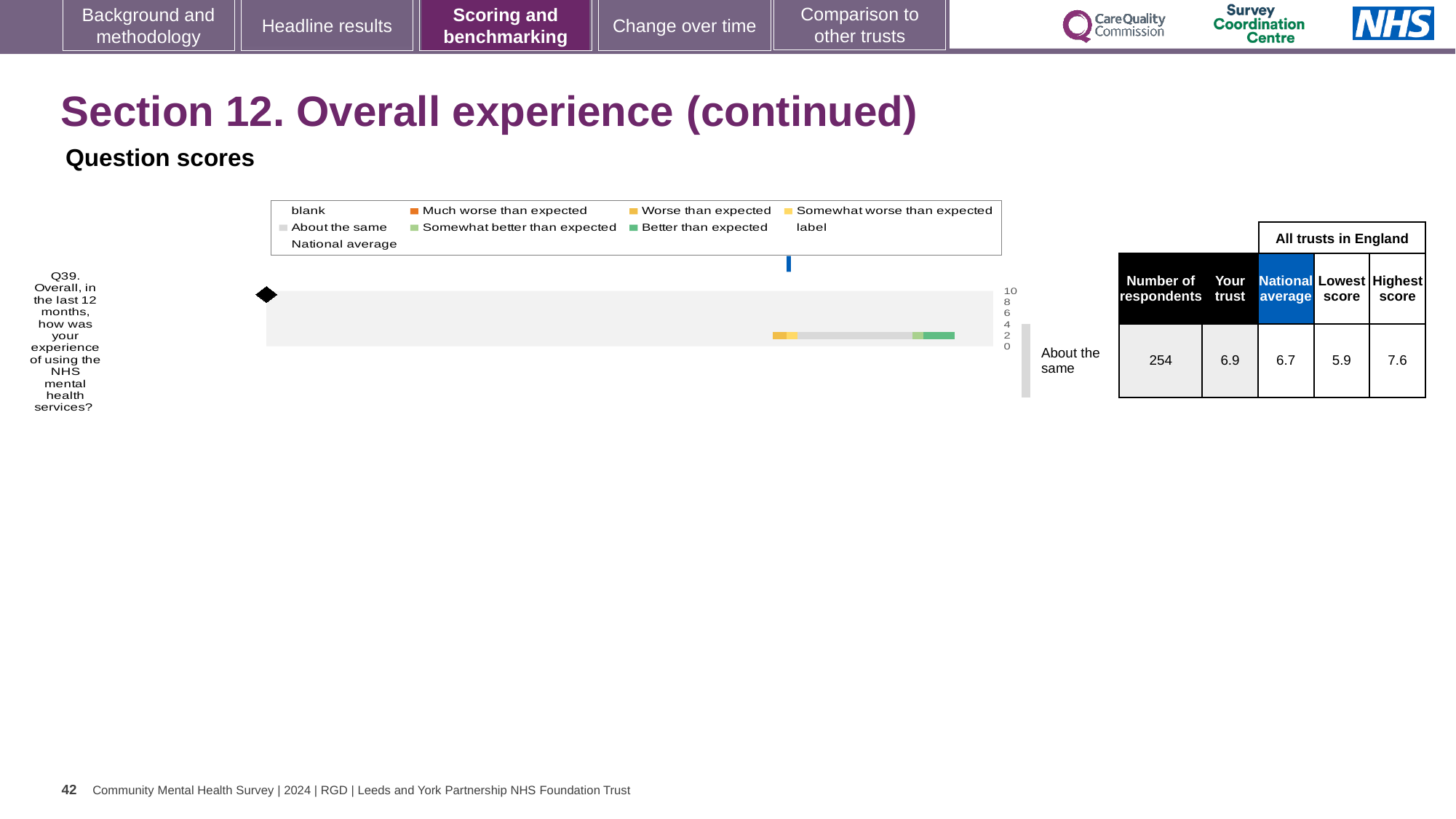
How many questions are plotted on the chart? 1 What kind of chart is shown on the slide? Bar chart How many respondents answered Q39? 254 What is the difference between the highest and lowest scores among all trusts in England for Q39? 1.7 Which is larger for Q39, the 'Your trust' score or the national average? Your trust How is the trust's result for Q39 categorised, according to the label beside the chart? About the same What is the lowest score among all trusts in England for Q39? 5.9 What is the difference between the 'Your trust' score and the national average for Q39? 0.2 What is the national average score for Q39 shown in the table? 6.7 What is the highest score among all trusts in England for Q39? 7.6 What colour does the legend use for 'Better than expected'? Green What is the 'Your trust' score for Q39 shown in the table next to the chart? 6.9